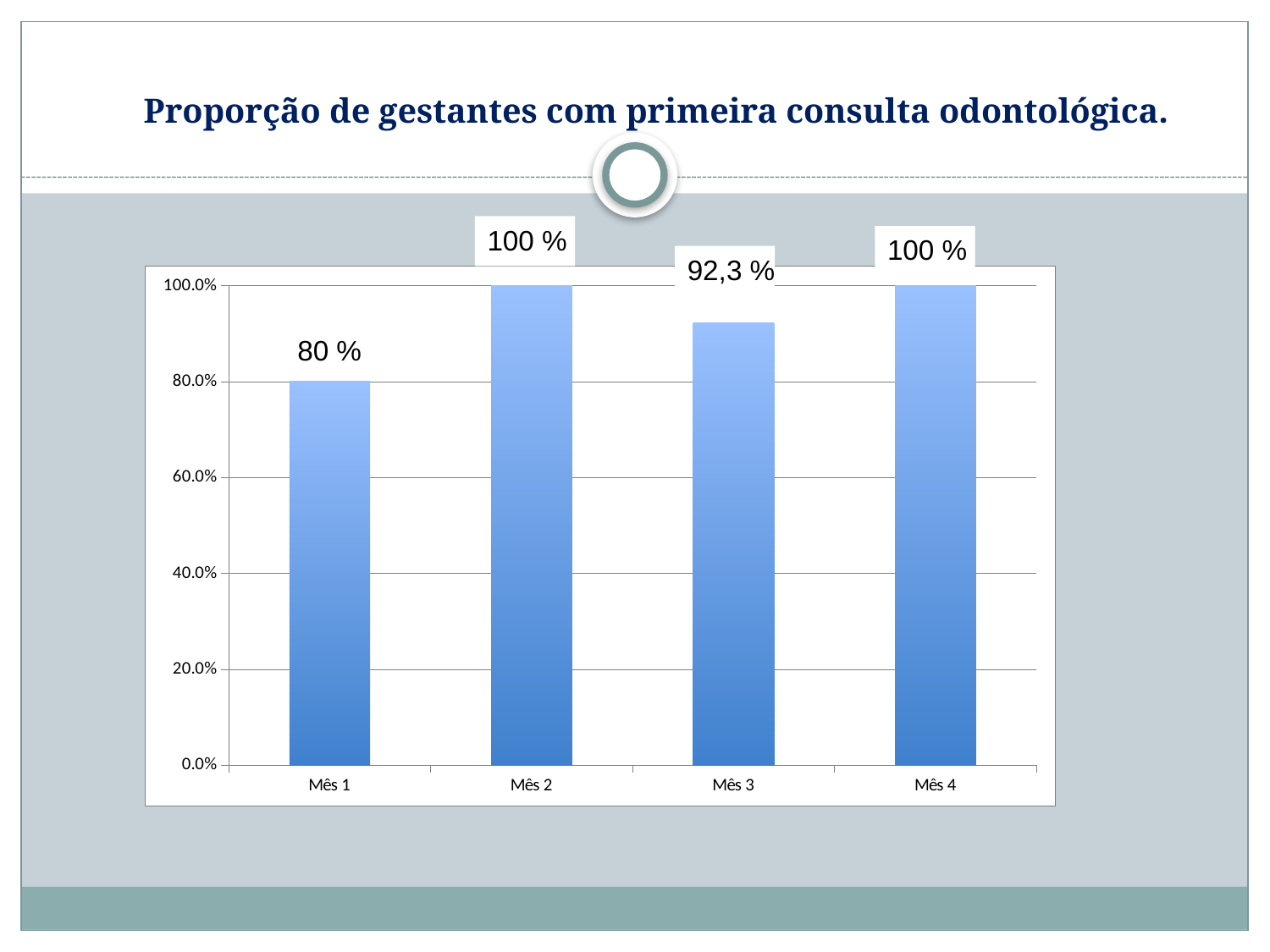
Which month has the lowest value? Mês 1 What is the value for Mês 2? 100 % What is the difference between the values for Mês 2 and Mês 1? 20 % How many months are shown on the x axis? 4 Which is larger, the value for Mês 3 or the value for Mês 4? Mês 4 What kind of chart is shown on the slide? Bar chart Is the value for Mês 3 greater or less than 80.0%? greater What is the difference between the values for Mês 3 and Mês 1? 12,3 % What is the value for Mês 3? 92,3 % Does the value rise or fall from Mês 1 to Mês 2? Rise What is the title of the slide? Proporção de gestantes com primeira consulta odontológica. What is the value for Mês 1? 80 %